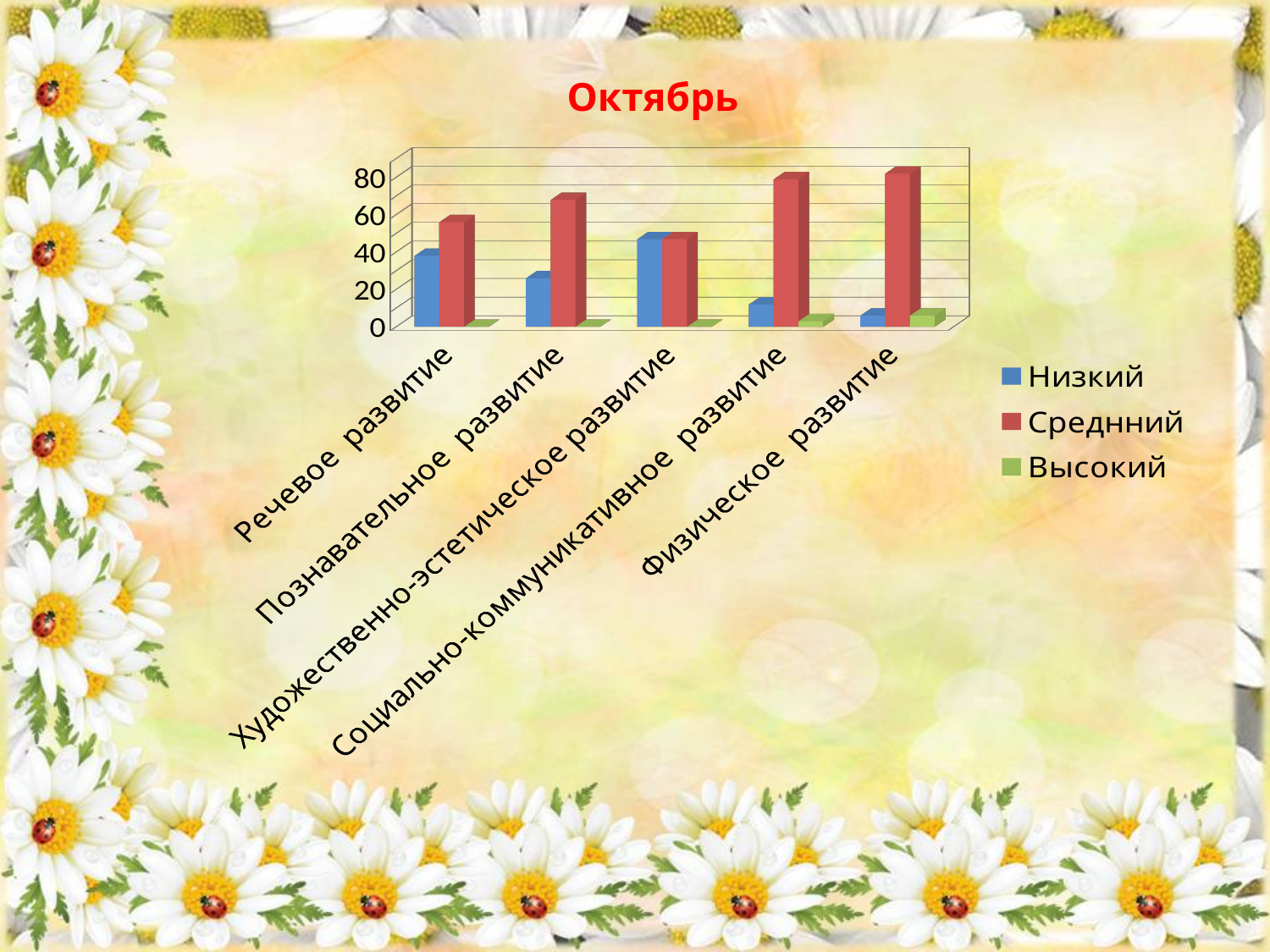
Is the value of Низкий for Социально-коммуникативное развитие greater or less than 20? less Is the value of Среднний for Социально-коммуникативное развитие greater or less than 60? greater Is the value of Среднний for Познавательное развитие greater or less than 60? greater Which category has the highest value for the series Низкий? Художественно-эстетическое развитие Which category has the lowest value for the series Среднний? Художественно-эстетическое развитие What is the title of the chart? Октябрь For Речевое развитие, which is larger: Низкий or Среднний? Среднний How many categories are shown on the x axis? 5 How many series does the legend list? 3 Which colour represents the series Высокий in the legend? green What kind of chart is shown on the slide? bar chart